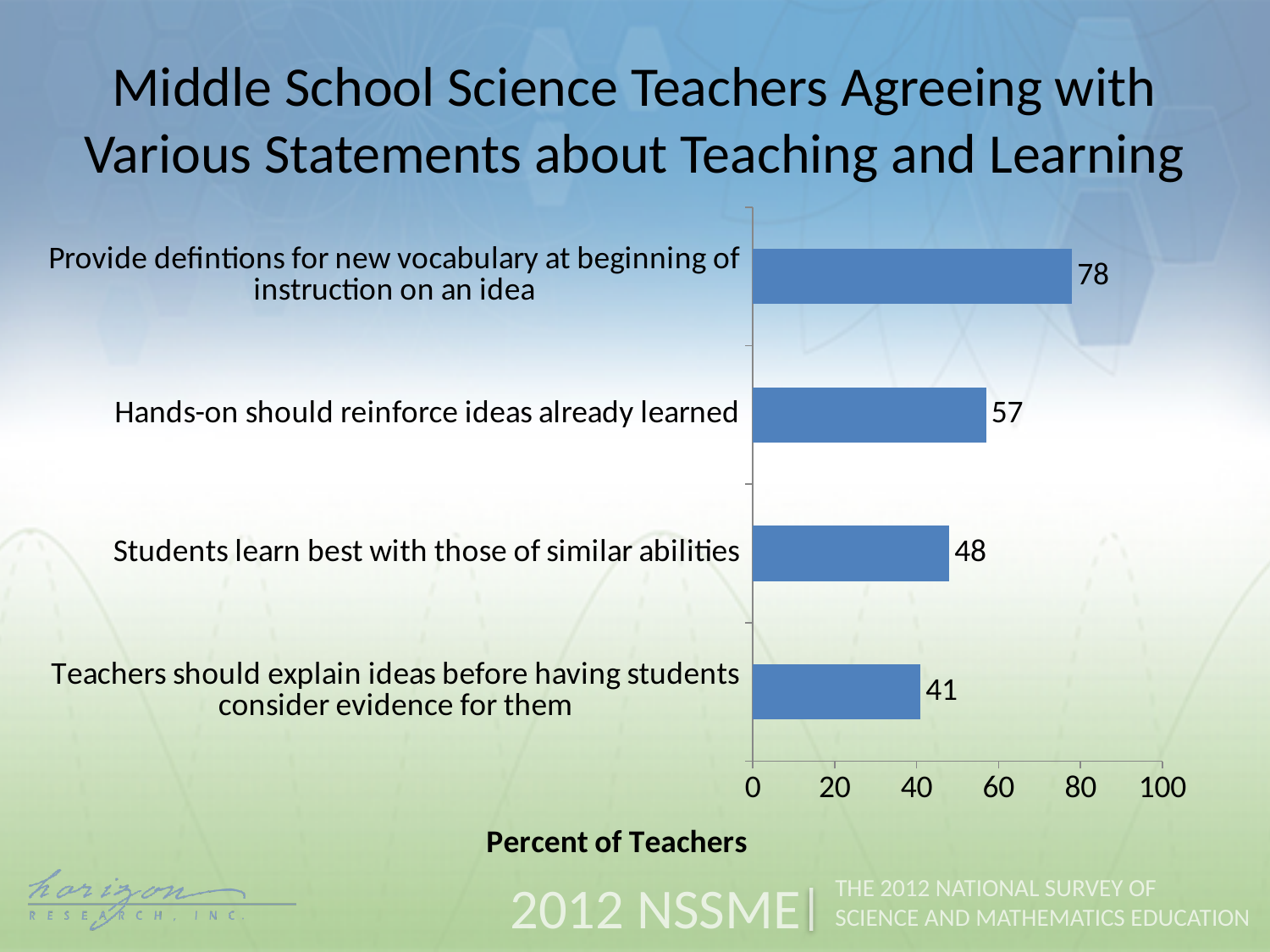
Is the value for 'Hands-on should reinforce ideas already learned' greater or less than 60? less Which statement has the lowest percent of teachers agreeing? Teachers should explain ideas before having students consider evidence for them What kind of chart is shown on the slide? Bar chart Which statement has the highest percent of teachers agreeing? Provide defintions for new vocabulary at beginning of instruction on an idea Which has a higher percent of teachers agreeing: students learn best with those of similar abilities, or teachers should explain ideas before having students consider evidence for them? Students learn best with those of similar abilities What percent of teachers agree that teachers should explain ideas before having students consider evidence for them? 41 What percent of teachers agree that hands-on should reinforce ideas already learned? 57 What is the difference in percent of teachers between the vocabulary definitions statement and the hands-on statement? 21 What percent of teachers agree that they should provide definitions for new vocabulary at the beginning of instruction on an idea? 78 How many statements are shown in the chart? 4 What percent of teachers agree that students learn best with those of similar abilities? 48 What is the label on the horizontal axis of the chart? Percent of Teachers